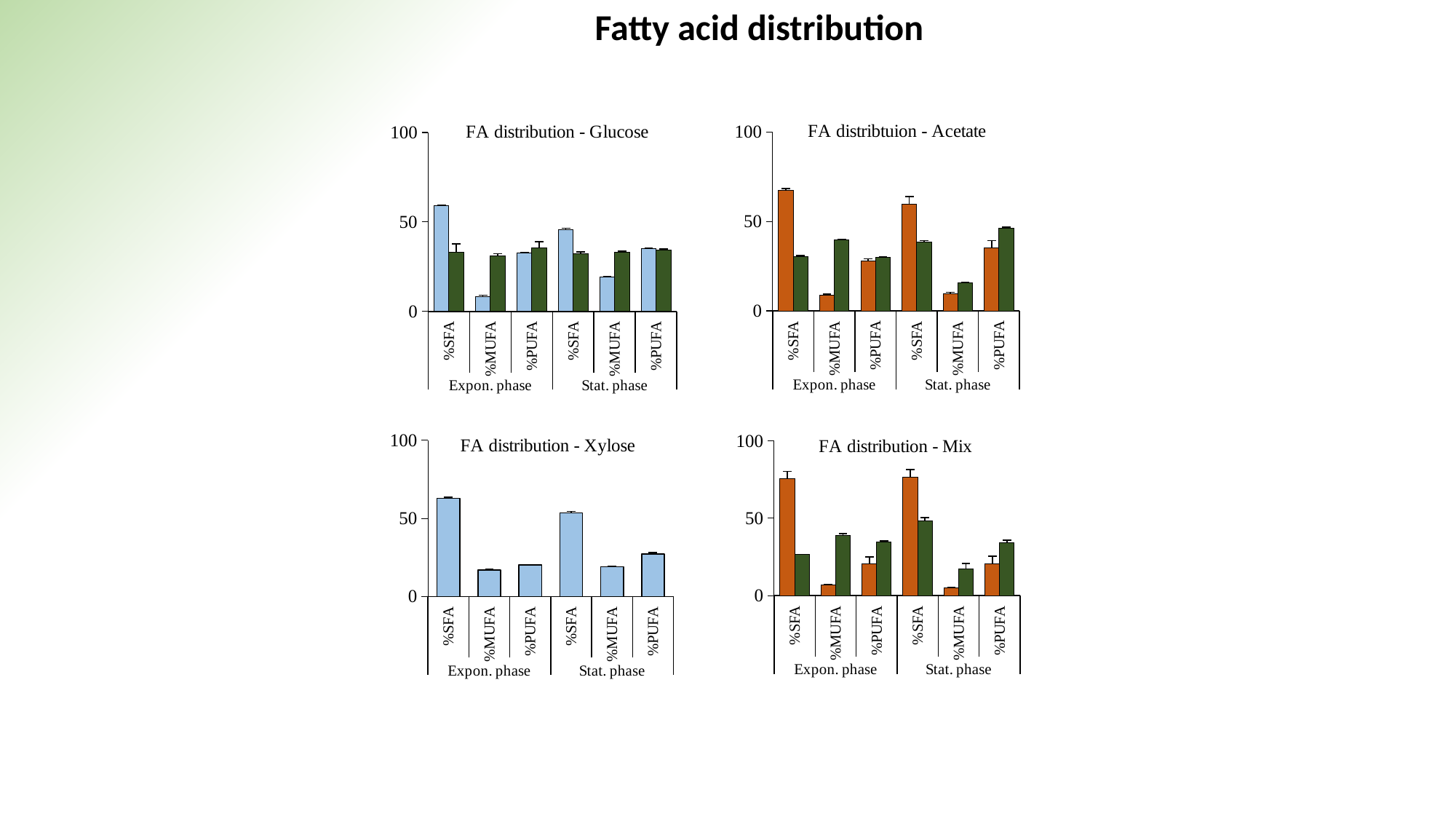
In the 'FA distribution - Xylose' chart, is the bar for %PUFA in the Stat. phase greater or less than 50? less In the 'FA distribution - Glucose' chart, how many category labels are shown on the x axis? 6 In the 'FA distribution - Mix' chart, is the orange bar for %SFA in the Stat. phase greater or less than 50? greater In the 'FA distribution - Glucose' chart, what kind of chart is shown? bar chart In the 'FA distribution - Xylose' chart, which category has the tallest bar? %SFA in the Expon. phase How many charts are shown on the slide? 4 In the 'FA distribution - Glucose' chart, which is larger for %MUFA in the Expon. phase, the blue bar or the green bar? the green bar In the 'FA distribtuion - Acetate' chart, is the orange bar for %SFA in the Expon. phase greater or less than 50? greater In the 'FA distribution - Xylose' chart, which is larger, %SFA in the Expon. phase or %SFA in the Stat. phase? %SFA in the Expon. phase In the 'FA distribtuion - Acetate' chart, which is larger for %MUFA in the Expon. phase, the orange bar or the green bar? the green bar In the 'FA distribution - Xylose' chart, how many bars are plotted? 6